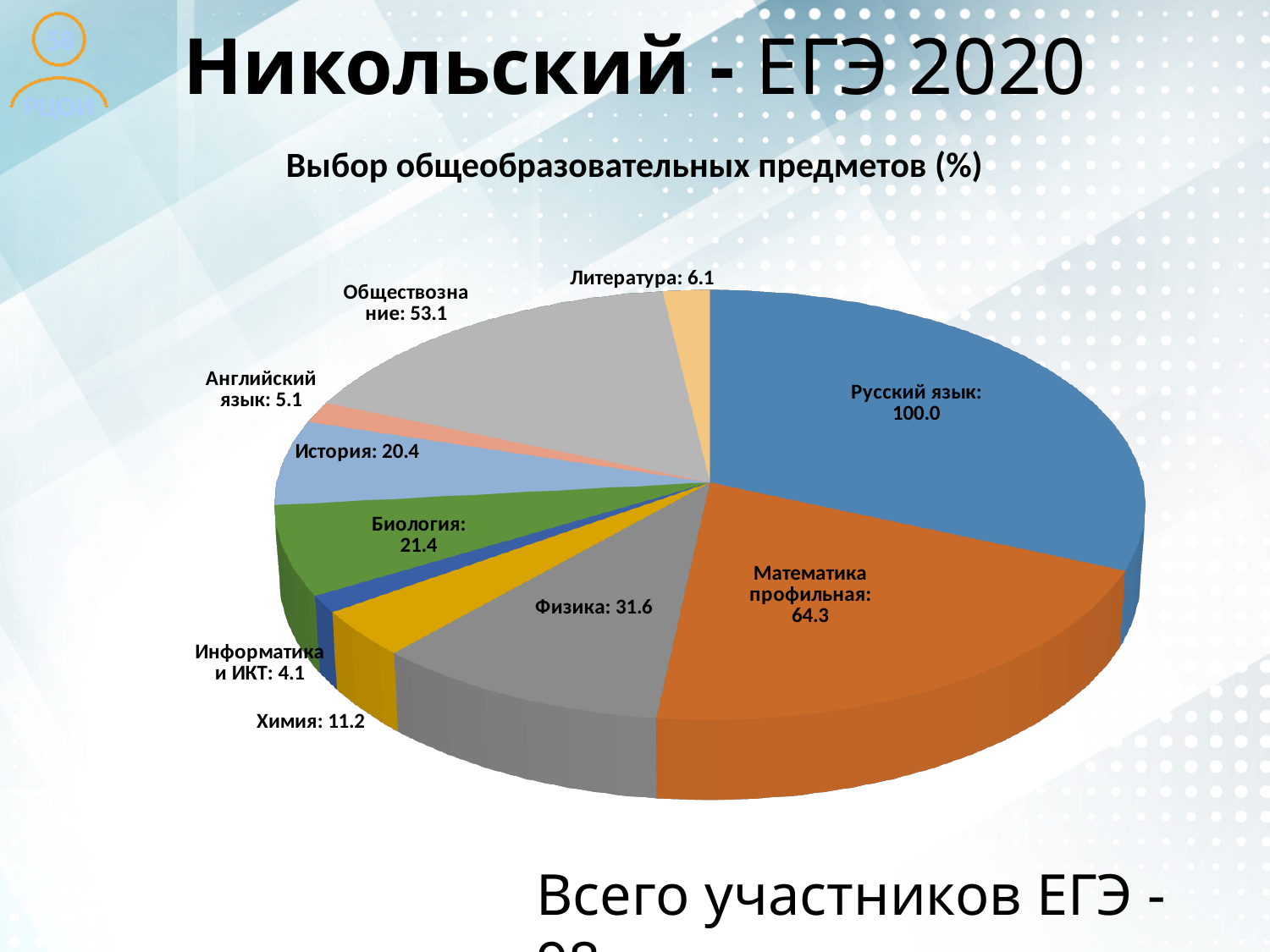
Which is larger, the value for Биология or the value for История? Биология What type of chart is shown on the slide? Pie chart What value is shown for Обществознание? 53.1 Which subject has the lowest value on the chart? Информатика и ИКТ What is the title of the chart? Выбор общеобразовательных предметов (%) What value is shown for Информатика и ИКТ? 4.1 What value is shown for Математика профильная? 64.3 What is the difference between the values for Физика and Химия? 20.4 What value is shown for Русский язык on the pie chart? 100.0 Which subject has the highest value on the chart? Русский язык What is the difference between the values for Русский язык and Математика профильная? 35.7 How many subjects are shown on the pie chart? 10